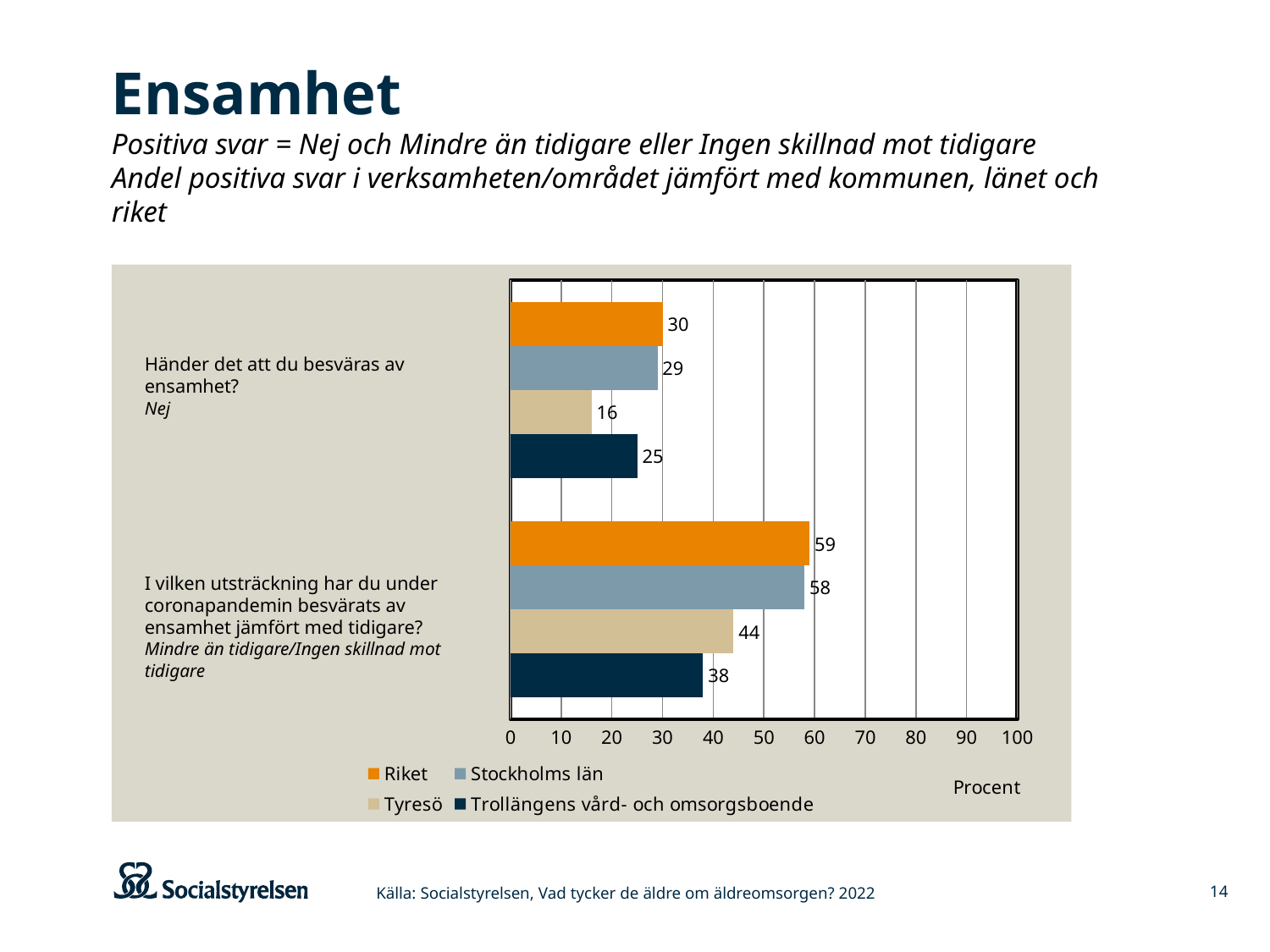
What is the difference between Trollängens vård- och omsorgsboende and Tyresö on the question "Händer det att du besväras av ensamhet?"? 9 On the question "Händer det att du besväras av ensamhet?", which is larger: Tyresö or Trollängens vård- och omsorgsboende? Trollängens vård- och omsorgsboende Which series has the lowest value on the question "I vilken utsträckning har du under coronapandemin besvärats av ensamhet jämfört med tidigare?"? Trollängens vård- och omsorgsboende What is the value for Tyresö on the question "Händer det att du besväras av ensamhet?"? 16 What is the difference between Riket and Trollängens vård- och omsorgsboende on the question "I vilken utsträckning har du under coronapandemin besvärats av ensamhet jämfört med tidigare?"? 21 What kind of chart is shown on the slide? Bar chart Which series has the lowest value on the question "Händer det att du besväras av ensamhet?"? Tyresö What is the value for Riket on the question "Händer det att du besväras av ensamhet?"? 30 What is the value for Stockholms län on the question "I vilken utsträckning har du under coronapandemin besvärats av ensamhet jämfört med tidigare?"? 58 What unit is shown on the horizontal axis of the chart? Procent What is the value for Trollängens vård- och omsorgsboende on the question "I vilken utsträckning har du under coronapandemin besvärats av ensamhet jämfört med tidigare?"? 38 How many series does the legend list? 4